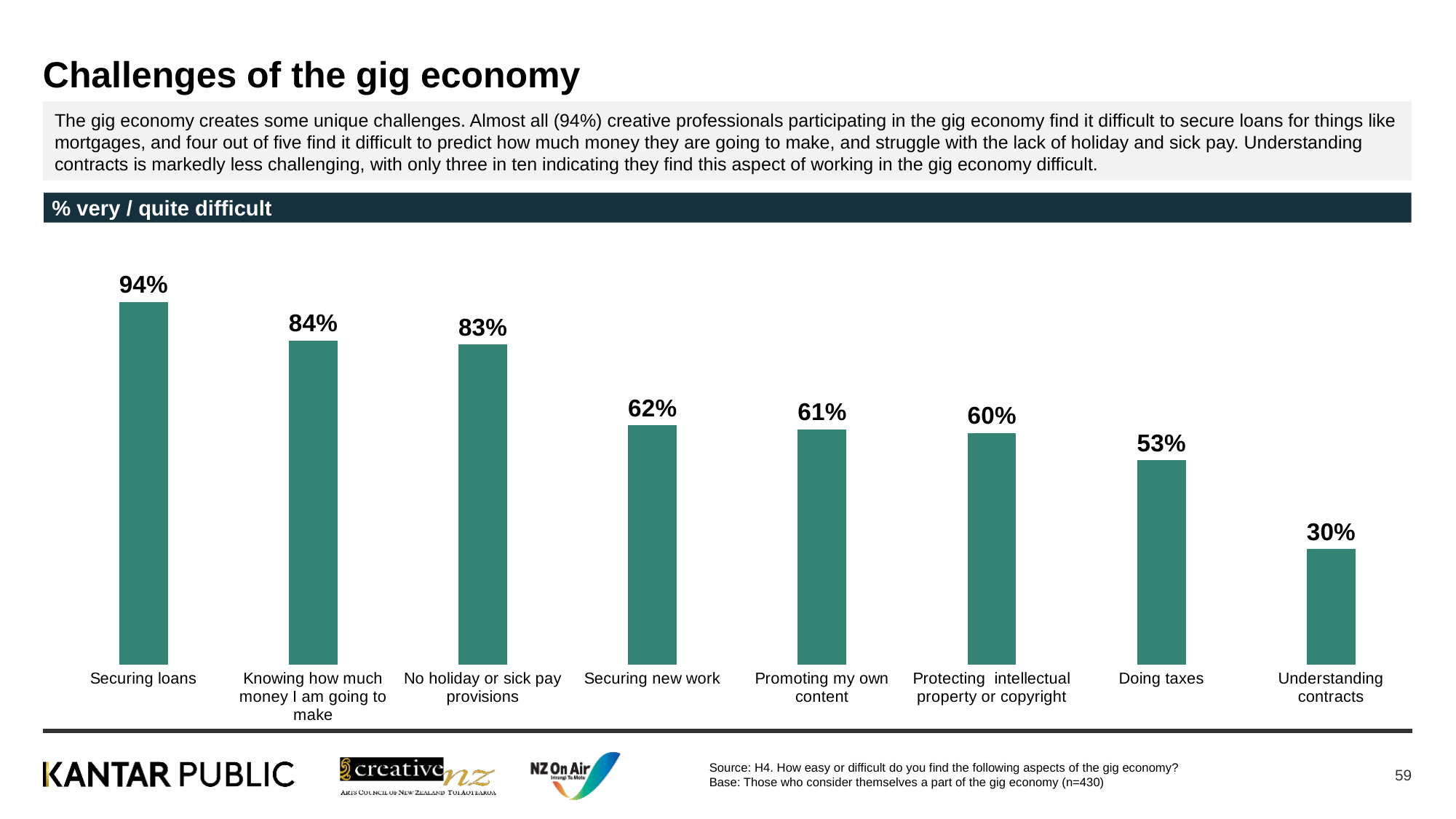
Which category has the lowest value in the chart? Understanding contracts What is the value shown for 'Promoting my own content'? 61% Which is larger: the value for 'No holiday or sick pay provisions' or the value for 'Doing taxes'? No holiday or sick pay provisions What is the value shown for 'Doing taxes'? 53% What percentage of respondents find securing loans very or quite difficult? 94% What is the difference between the values for 'Securing loans' and 'Understanding contracts'? 64% How many categories are shown in the chart? 8 Which category has the highest value in the chart? Securing loans What kind of chart is shown on the slide? Bar chart What is the title shown in the dark banner above the chart? % very / quite difficult Do the values rise or fall moving from left to right along the x axis? Fall What is the difference between the values for 'Knowing how much money I am going to make' and 'Securing new work'? 22%